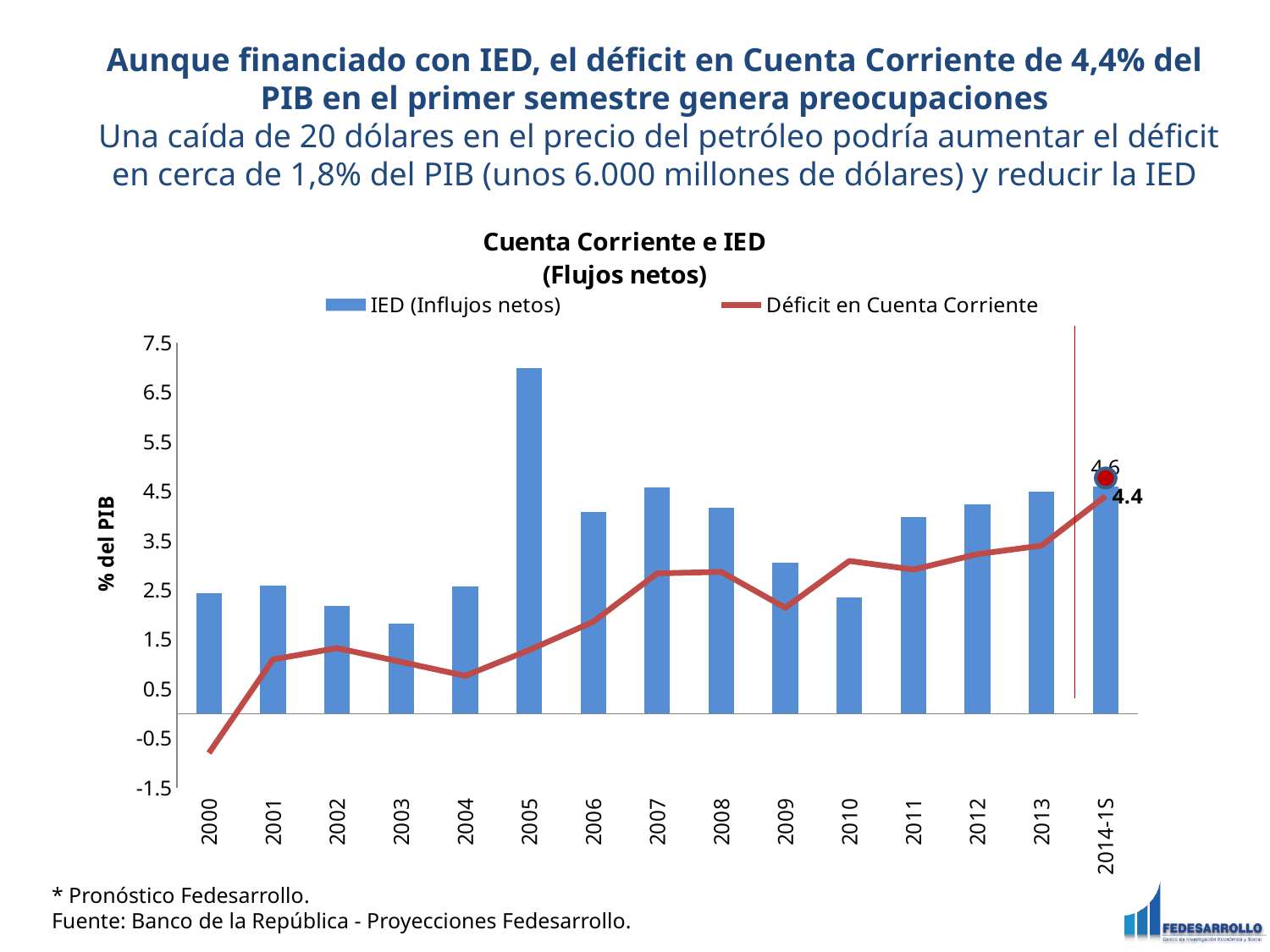
For 2014-1S, which is larger: IED (Influjos netos) or Déficit en Cuenta Corriente? IED (Influjos netos) What is the value of Déficit en Cuenta Corriente for 2014-1S? 4.4 How many time periods are shown on the x axis? 15 What is the value of IED (Influjos netos) for 2014-1S? 4.6 In which year is the IED (Influjos netos) bar the lowest? 2003 How many series does the legend list? 2 What is the label of the vertical axis? % del PIB Is the IED (Influjos netos) value for 2005 greater or less than 6.5? greater What is the difference between IED (Influjos netos) and Déficit en Cuenta Corriente in 2014-1S? 0.2 Is the Déficit en Cuenta Corriente value for 2009 greater or less than 2.5? less In which year is the IED (Influjos netos) bar the highest? 2005 In which year is the Déficit en Cuenta Corriente line at its lowest point? 2000